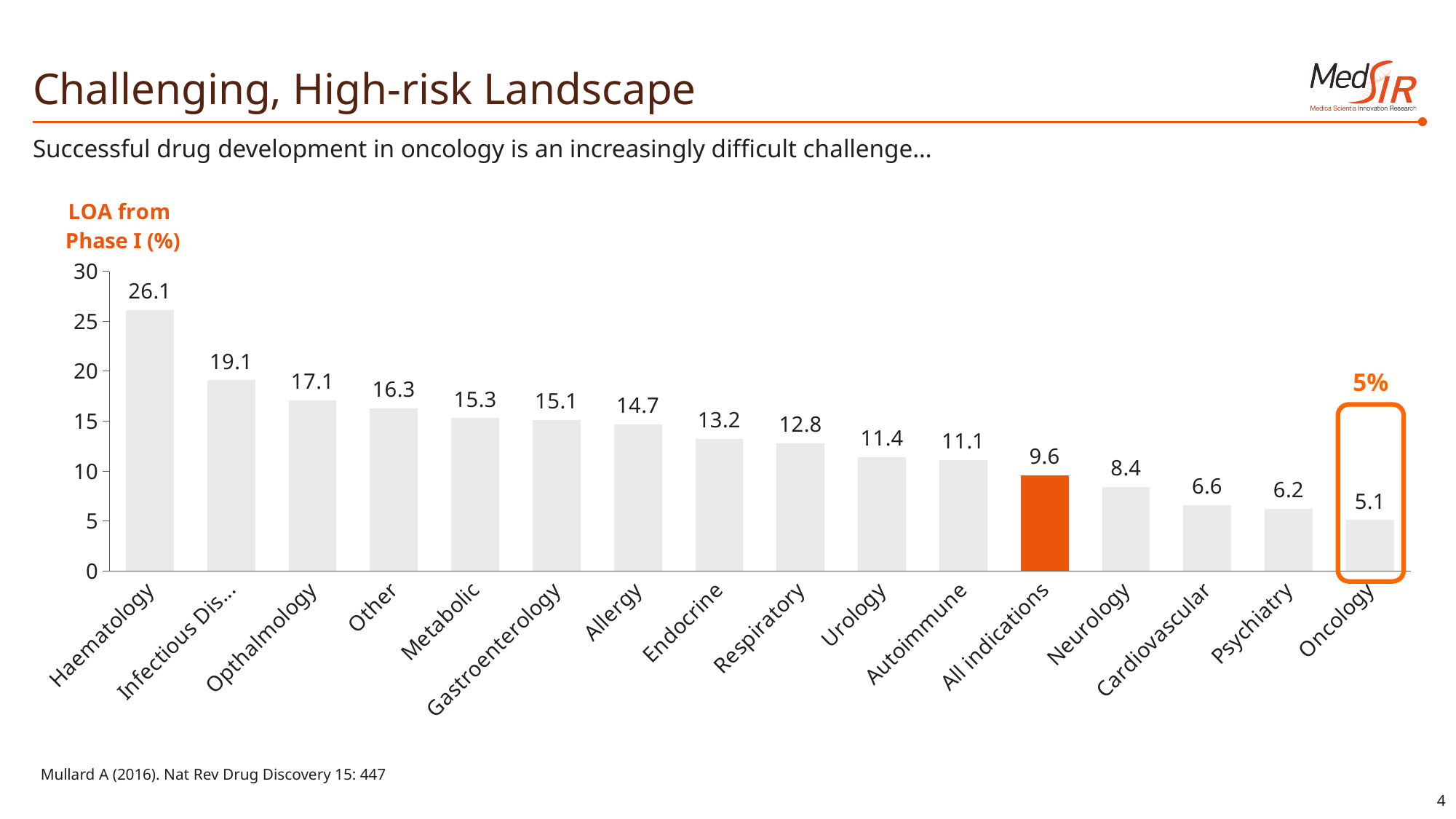
Which category has the highest LOA from Phase I? Haematology How many categories are shown on the x axis of the chart? 16 What is the value shown for Cardiovascular? 6.6 What kind of chart is shown on the slide? Bar chart Which category has the lowest LOA from Phase I? Oncology What is the value shown for All indications? 9.6 What is the difference between the values for Haematology and Oncology? 21.0 What is the LOA from Phase I (%) for Oncology? 5.1 Which bar is highlighted in dark orange? All indications Which has a higher LOA from Phase I, Endocrine or Neurology? Endocrine What is the difference between the values for All indications and Oncology? 4.5 What is the LOA from Phase I (%) for Haematology? 26.1